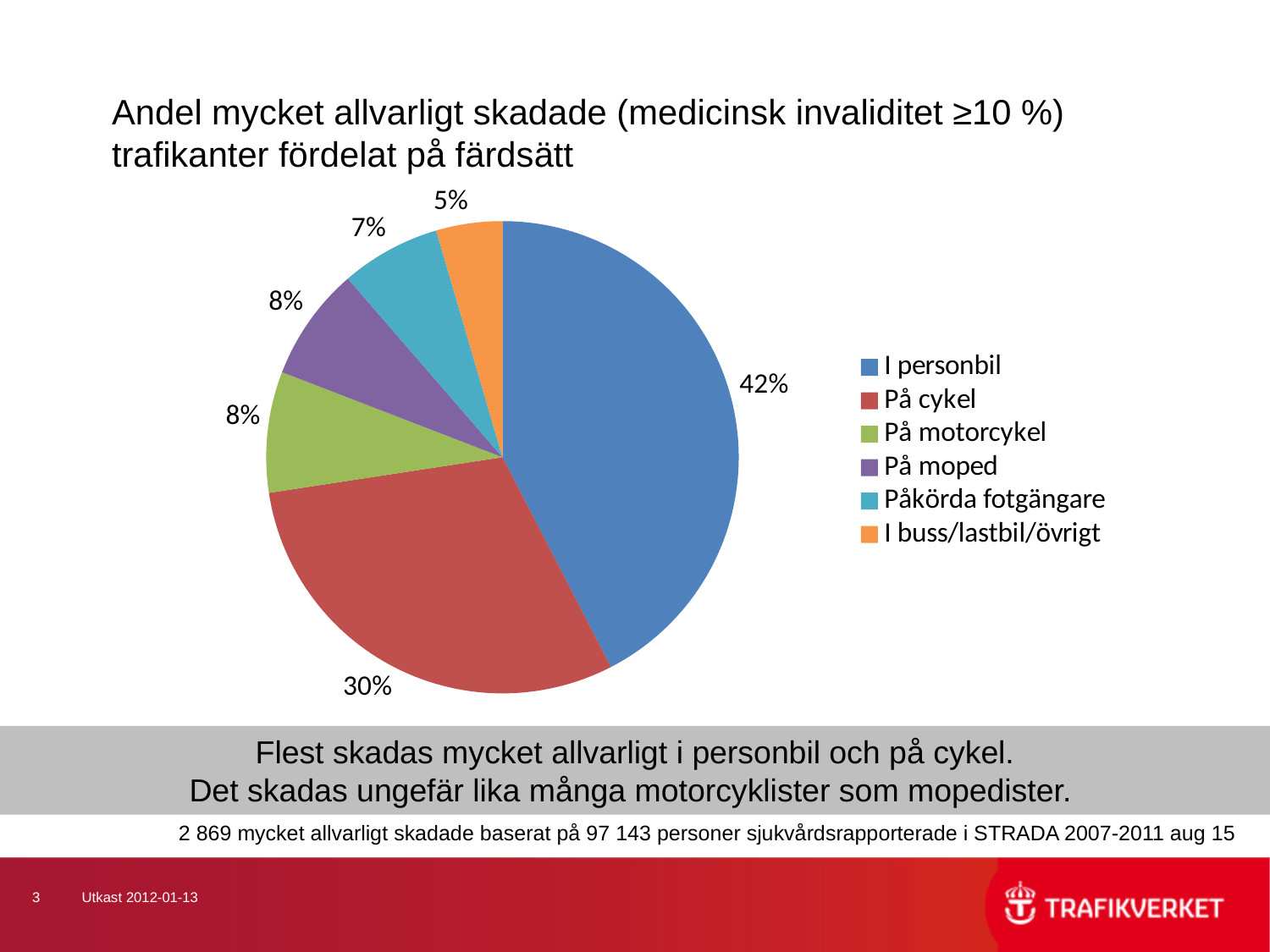
What colour is the slice for "På motorcykel"? Green What share of the pie is labelled for "Påkörda fotgängare"? 7% What share of the pie is labelled for "I personbil"? 42% Which category has the largest slice of the pie? I personbil Which category has the smallest slice of the pie? I buss/lastbil/övrigt How many categories does the legend of the pie chart list? 6 Which slice is larger, "På cykel" or "På motorcykel"? På cykel What is the difference in percentage points between the "I personbil" slice and the "På cykel" slice? 12 What kind of chart is shown on the slide? Pie chart What share of the pie is labelled for "I buss/lastbil/övrigt"? 5% What share of the pie is labelled for "På moped"? 8% What share of the pie is labelled for "På cykel"? 30%